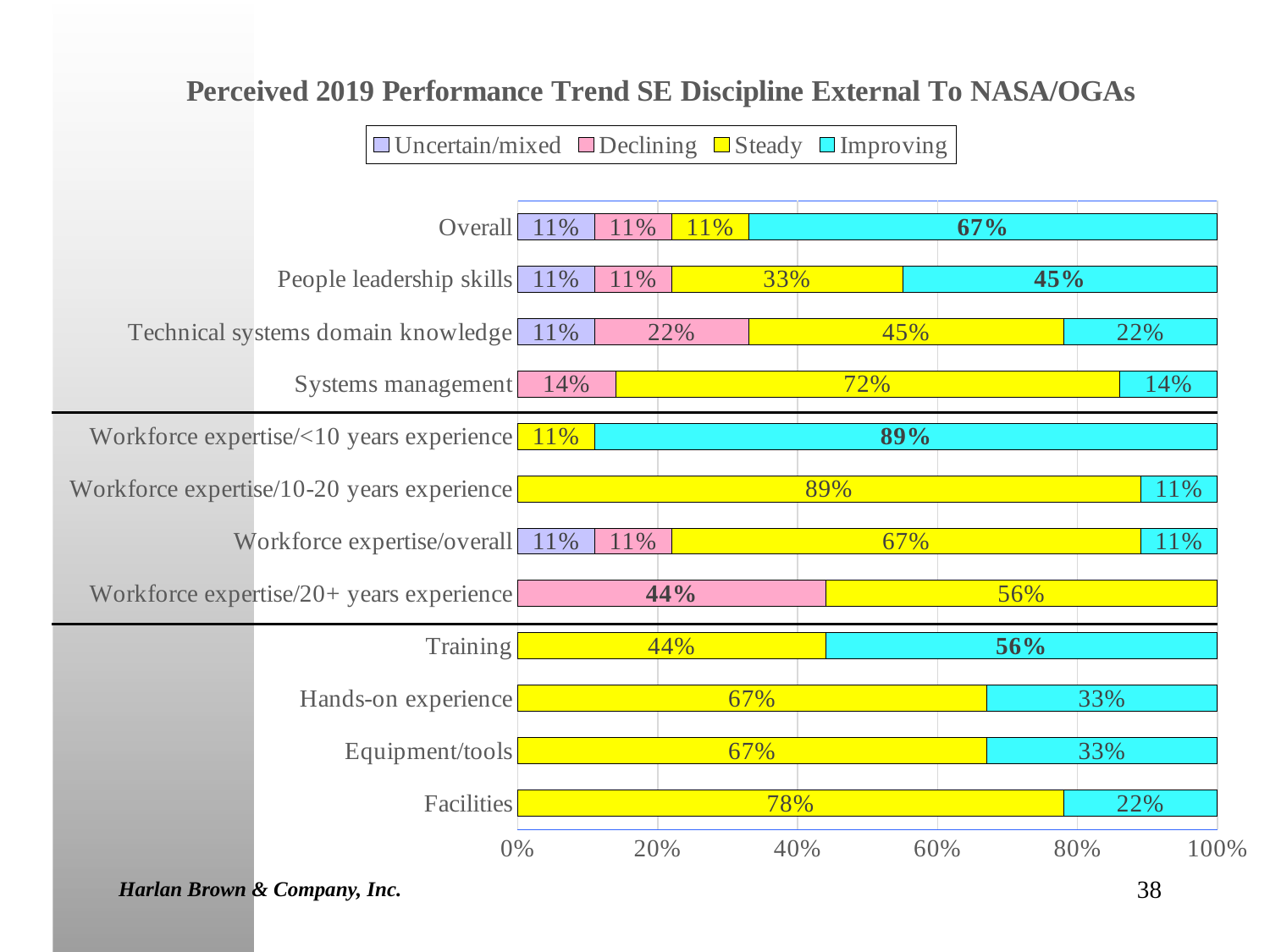
Which category has the highest Improving value? Workforce expertise/<10 years experience What is the difference between the Steady value for Facilities and the Steady value for Training? 34% Which category has the highest Steady value? Workforce expertise/10-20 years experience What is the Improving value for Facilities? 22% What is the Improving value for Overall? 67% How many series does the legend list? 4 Which is larger: the Improving value for Training or the Improving value for Hands-on experience? Training What kind of chart is shown on the slide? Stacked bar chart How many categories are shown on the chart? 12 What is the title of the chart? Perceived 2019 Performance Trend SE Discipline External To NASA/OGAs What is the Steady value for Systems management? 72% What is the Declining value for Workforce expertise/20+ years experience? 44%